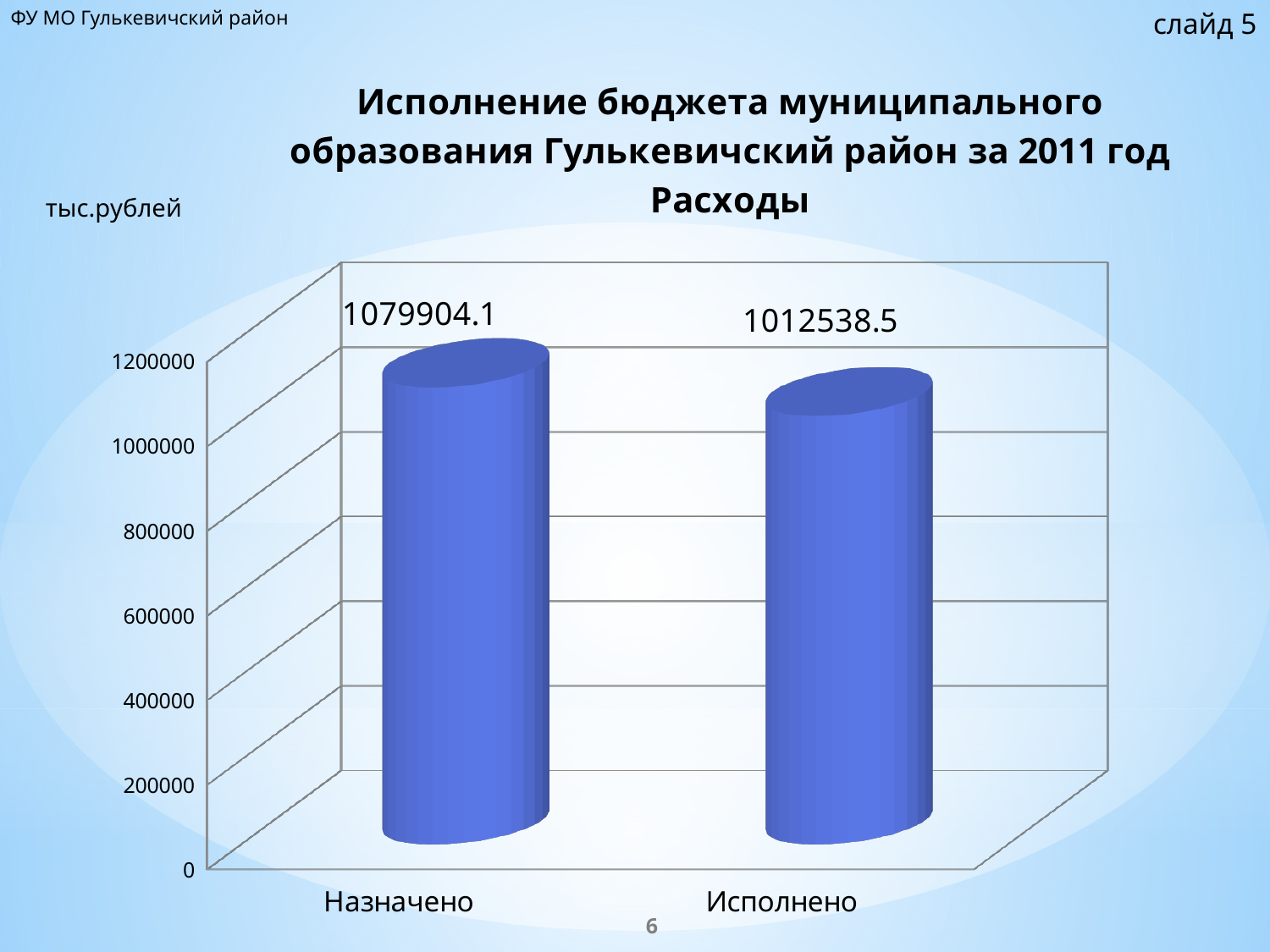
What is the value for Назначено? 1079904.1 Which is larger, the value for Назначено or the value for Исполнено? Назначено Which category has the lowest value? Исполнено In what units are the values on the chart given? тыс.рублей What is the difference between the values for Назначено and Исполнено? 67365.6 What kind of chart is shown on the slide? bar chart Which category has the highest value? Назначено How many categories are shown on the chart? 2 What is the value for Исполнено? 1012538.5 Is the value for Исполнено greater or less than 1000000? greater Is the value for Назначено greater or less than 1200000? less What is the title of the chart? Исполнение бюджета муниципального образования Гулькевичский район за 2011 год Расходы